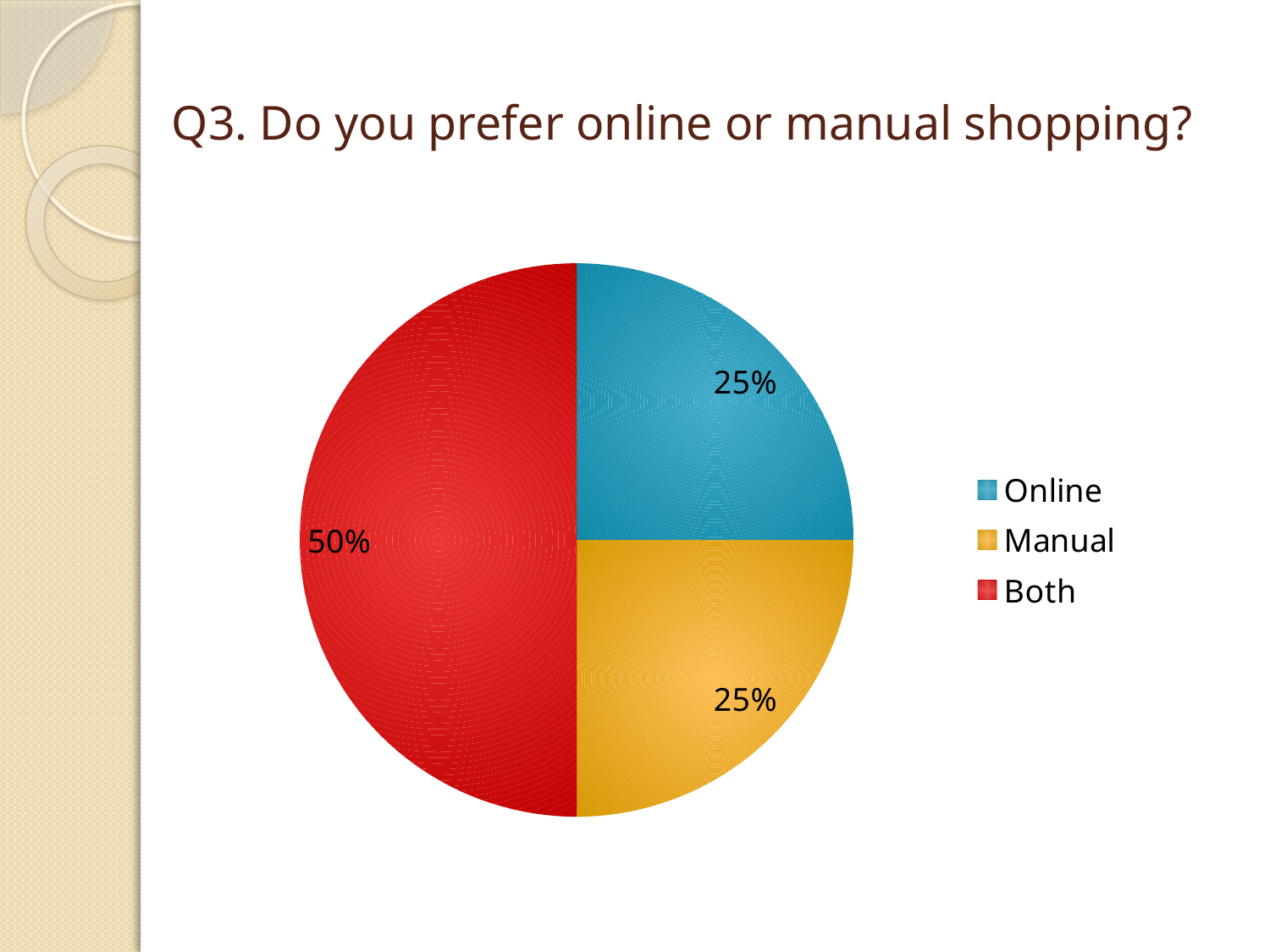
How many slices does the pie chart have? 3 What is the title of the chart slide? Q3. Do you prefer online or manual shopping? What colour is the slice for Both? red What share of the pie does Manual account for? 25% What is the difference between the share for Both and the share for Online? 25% What kind of chart is shown on the slide? pie chart What share of the pie does Both account for? 50% How many entries does the legend list? 3 What is the combined share of Online and Manual? 50% What share of the pie does Online account for? 25% Which is larger, the share for Both or the share for Manual? Both Which category has the largest slice of the pie? Both